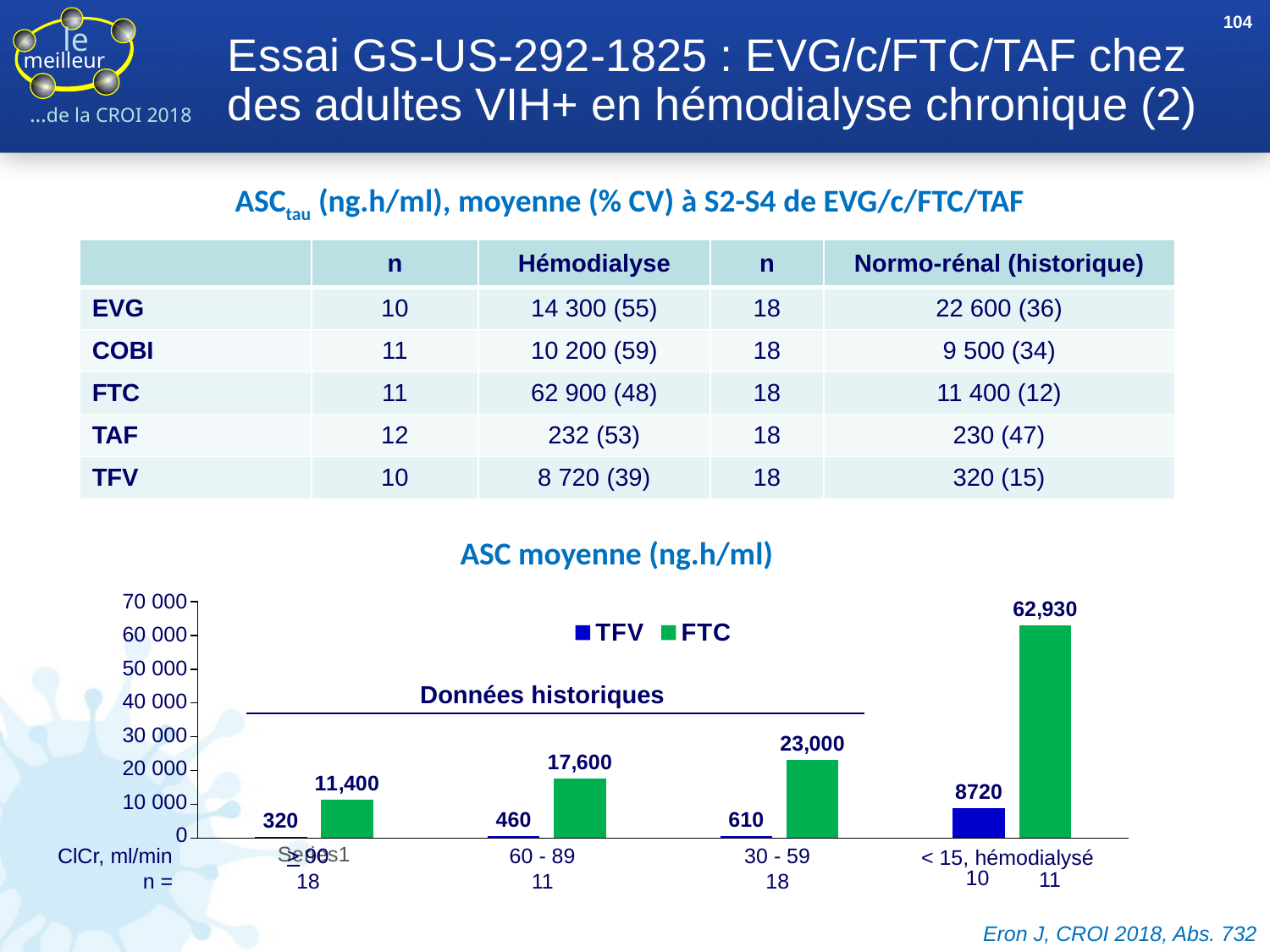
In the ASC moyenne chart, which has the larger TFV value: 60 - 89 or 30 - 59? 30 - 59 In the ASC moyenne chart, which ClCr category has the highest FTC value? < 15, hémodialysé What kind of chart is the ASC moyenne chart? Bar chart How many series does the legend of the ASC moyenne chart list? 2 In the ASC moyenne chart, what is the TFV value for the < 15, hémodialysé category? 8720 In the ASC moyenne chart, what is the difference between the FTC and TFV values in the < 15, hémodialysé category? 54,210 In the ASC moyenne chart, what is the FTC value for the < 15, hémodialysé category? 62,930 In the ASC moyenne chart, what is the difference between the FTC values for 30 - 59 and 60 - 89? 5,400 How many ClCr categories are shown on the x axis of the ASC moyenne chart? 4 In the ASC moyenne chart, do the FTC values rise or fall from left to right across the ClCr categories? Rise In the ASC moyenne chart, what is the FTC value for the 60 - 89 ClCr category? 17,600 In the ASC moyenne chart, what is the TFV value for the 30 - 59 ClCr category? 610